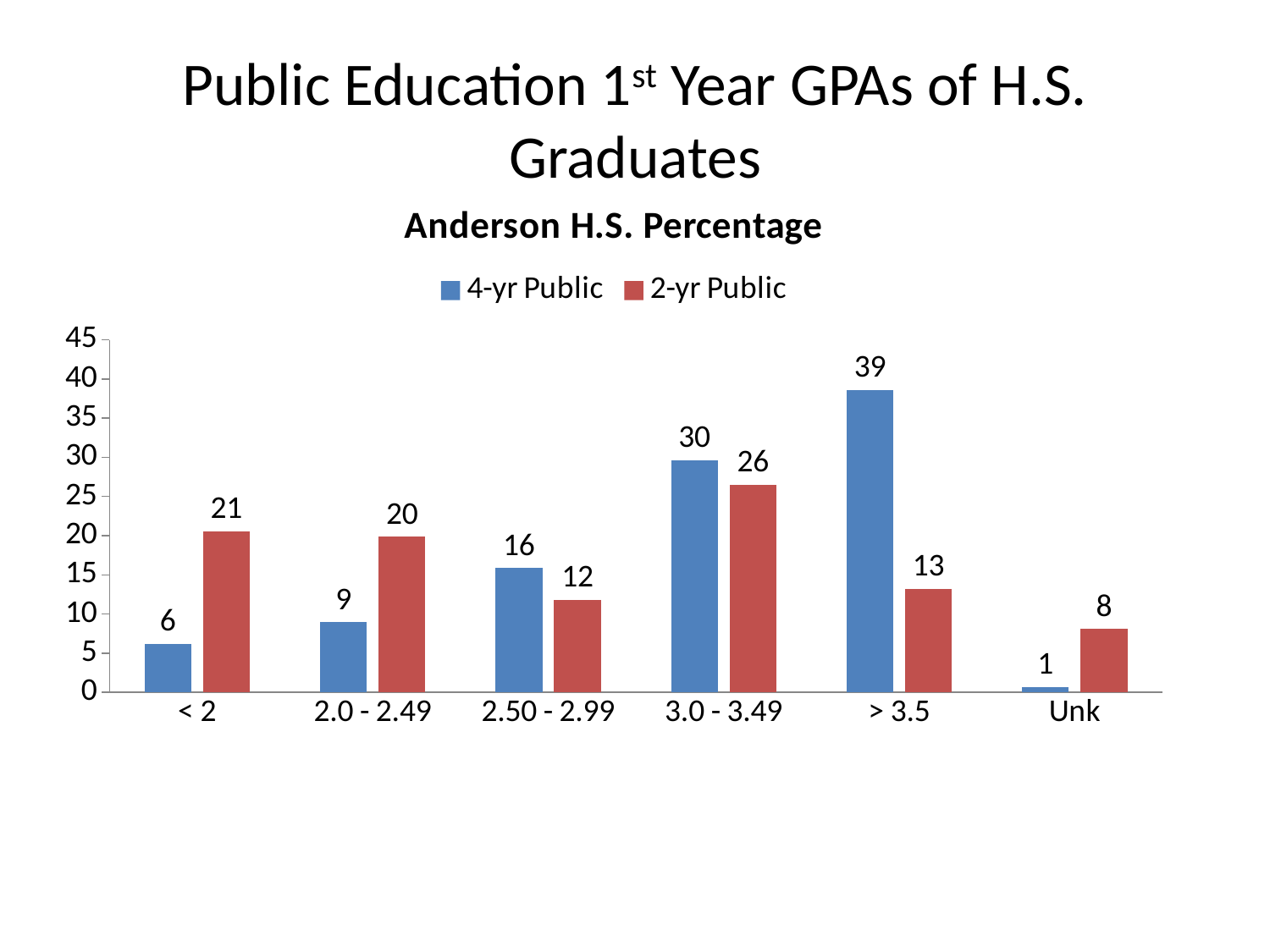
What is the difference between the 4-yr Public and 2-yr Public values for the > 3.5 category? 26 How many series does the legend list? 2 Which GPA category has the lowest 2-yr Public value? Unk What is the 2-yr Public value for the 3.0 - 3.49 category? 26 How many GPA categories are shown on the x axis? 6 For the 2.0 - 2.49 category, which series has the larger value, 4-yr Public or 2-yr Public? 2-yr Public Is the 4-yr Public value for the 3.0 - 3.49 category greater or less than 25? greater What is the 2-yr Public value for the < 2 GPA category? 21 What kind of chart is shown on the slide? bar chart What is the title of the chart? Anderson H.S. Percentage What is the 4-yr Public value for the > 3.5 GPA category? 39 Which GPA category has the highest 4-yr Public value? > 3.5